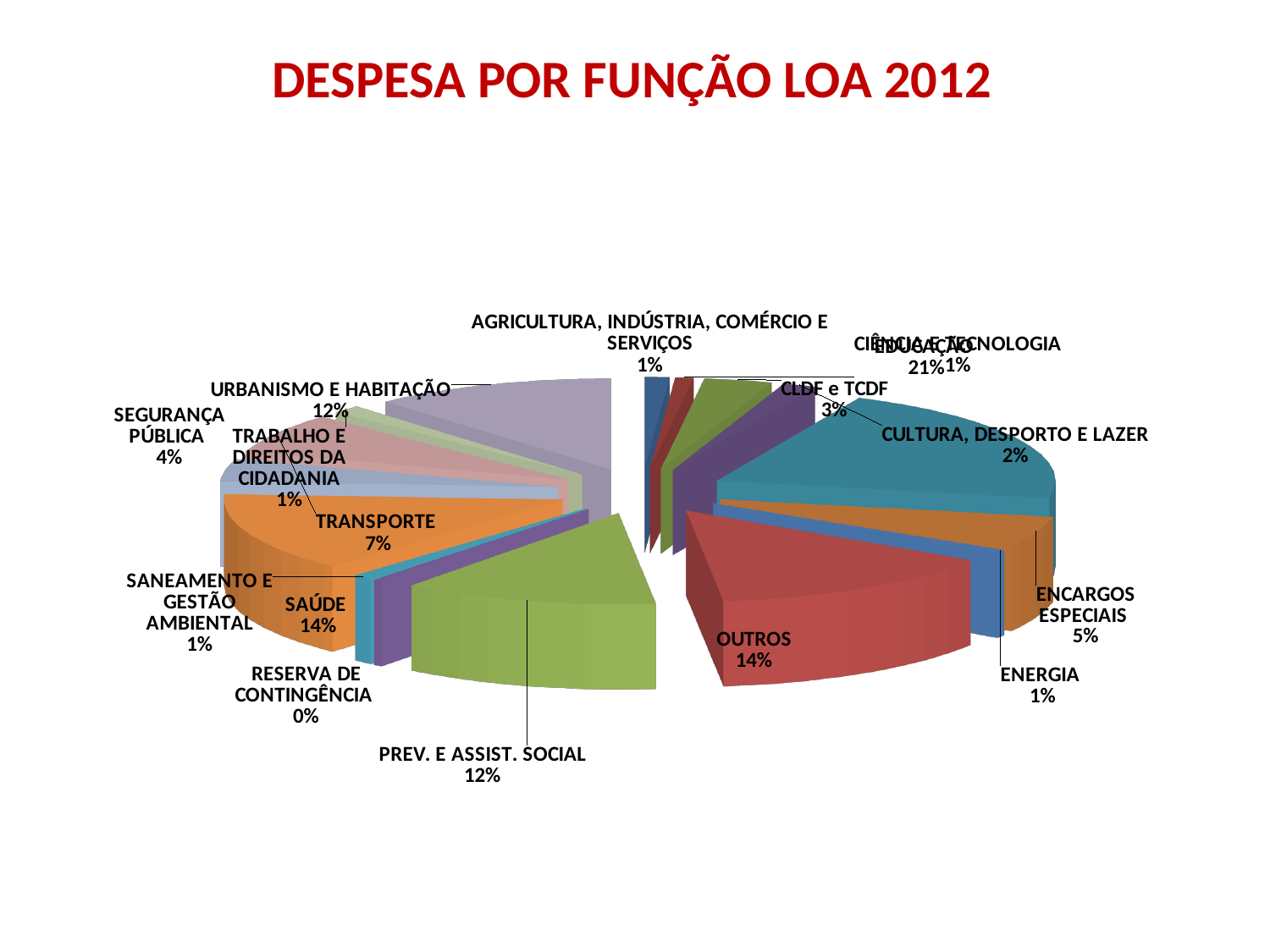
What kind of chart is shown on the slide? Pie chart What percentage is shown for ENCARGOS ESPECIAIS? 5% What percentage is shown for TRANSPORTE? 7% What percentage is shown for CLDF e TCDF? 3% What percentage of the pie is SAÚDE? 14% How many categories are shown in the pie chart? 16 Which category has the smallest share of the pie? RESERVA DE CONTINGÊNCIA Which is larger, SEGURANÇA PÚBLICA or CULTURA, DESPORTO E LAZER? SEGURANÇA PÚBLICA What is the title of the chart? DESPESA POR FUNÇÃO LOA 2012 What percentage is shown for URBANISMO E HABITAÇÃO? 12% Which category has the largest share of the pie? EDUCAÇÃO What is the difference in percentage points between OUTROS and PREV. E ASSIST. SOCIAL? 2